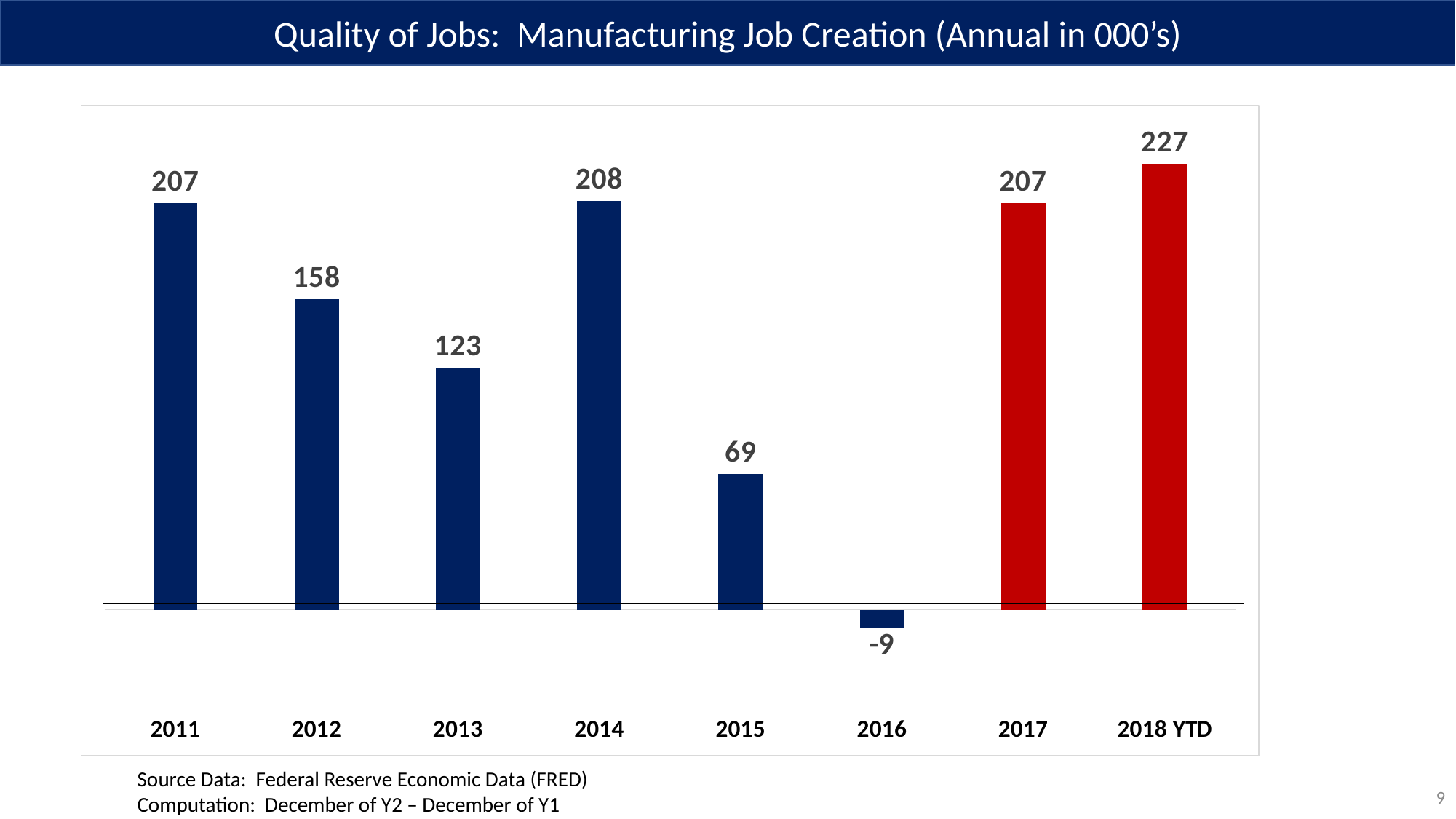
What is the difference between the values for 2012 and 2013? 35 Which year has the highest manufacturing job creation value? 2018 YTD Do the values rise or fall from 2011 to 2016? Fall (overall, though 2014 rises above 2013) What is the difference between the values for 2018 YTD and 2017? 20 What kind of chart is shown on the slide? Bar chart Which is larger, the value for 2015 or the value for 2013? 2013 What is the value shown for 2016? -9 Which years are shown with red bars? 2017 and 2018 YTD What is the value shown for 2018 YTD? 227 What is the manufacturing job creation value for 2014? 208 Which year has the lowest manufacturing job creation value? 2016 How many years (categories) are shown on the x axis? 8